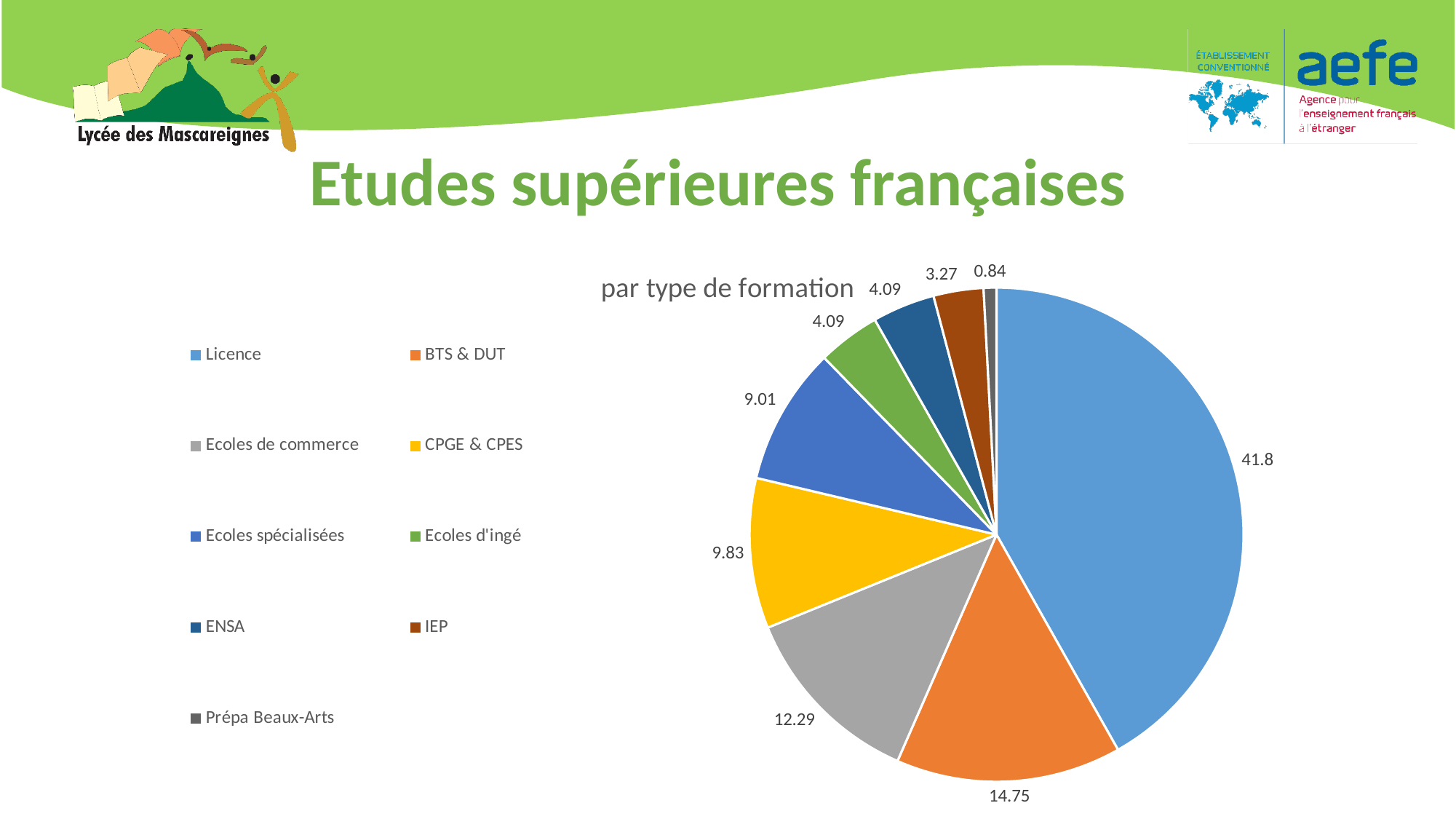
Which category has the smallest slice? Prépa Beaux-Arts What is the value for Ecoles de commerce? 12.29 What is the value for BTS & DUT? 14.75 What is the value for IEP? 3.27 Which is larger, Ecoles spécialisées or Ecoles de commerce? Ecoles de commerce What is the value for Licence? 41.8 Which category has the largest slice? Licence How many categories does the pie chart have? 9 What kind of chart is shown on the slide? pie chart What is the title of the chart? par type de formation What is the difference between the values for Licence and BTS & DUT? 27.05 What is the value for CPGE & CPES? 9.83